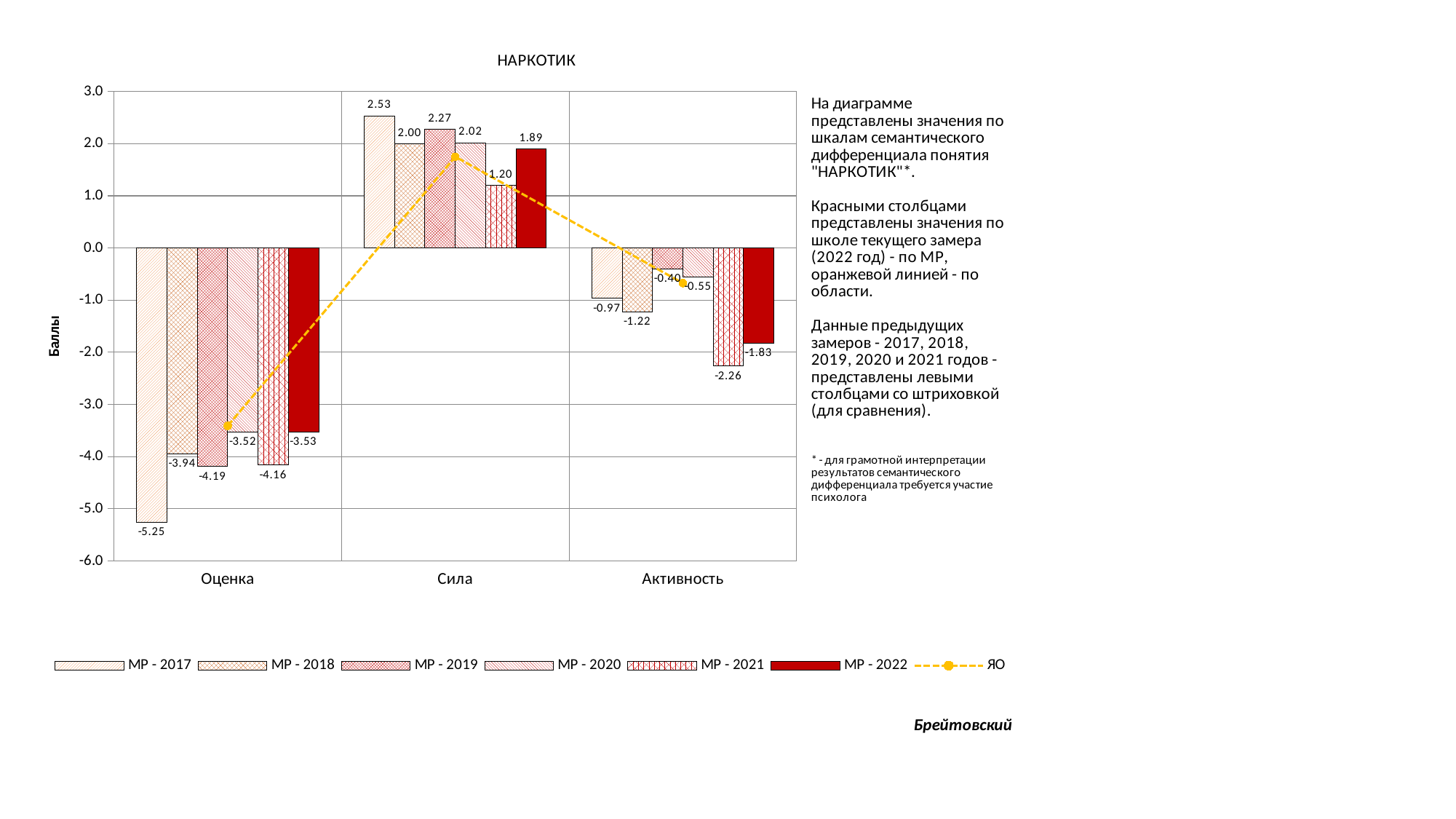
What is the value of МР - 2020 for Оценка? -3.52 Is the value of the ЯО line for Сила greater or less than 1.0? greater Which category has the lowest value for МР - 2017? Оценка What is the value of МР - 2021 for Активность? -2.26 What is the value of МР - 2017 for Оценка? -5.25 What is the difference between МР - 2017 and МР - 2022 for Сила? 0.64 What is the difference between МР - 2022 and МР - 2021 for Активность? 0.43 Which category has the highest value for МР - 2022? Сила How many series does the legend list? 7 How many categories are shown on the x axis? 3 For Активность, which is larger: МР - 2019 or МР - 2020? МР - 2019 What is the value of МР - 2022 for Сила? 1.89